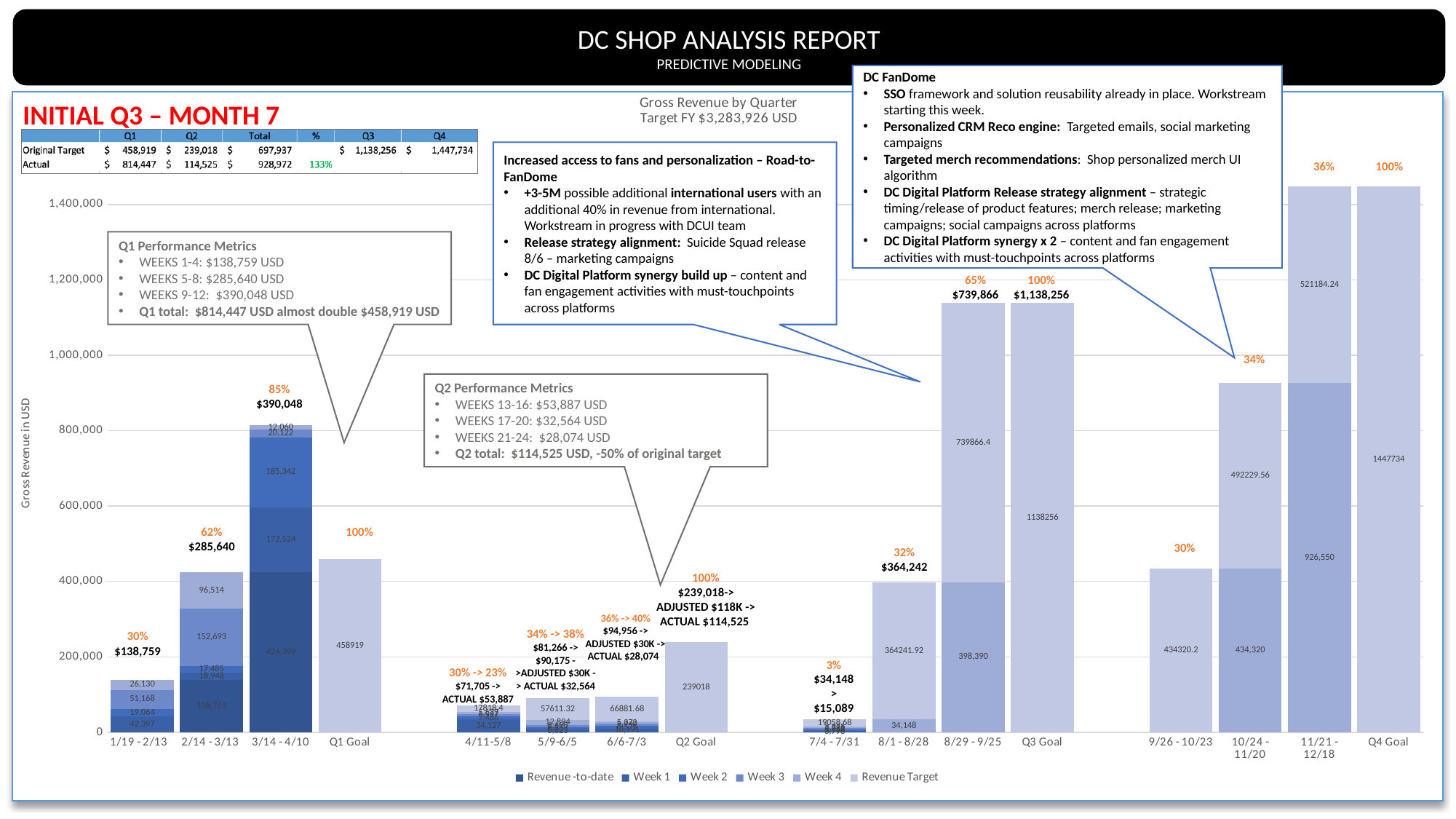
Which of the four quarterly goal bars (Q1 Goal, Q2 Goal, Q3 Goal, Q4 Goal) is the lowest? Q2 Goal How many categories are shown along the x axis of the chart? 16 What is the title of the vertical axis of the chart? Gross Revenue in USD What is the value labelled on the Q4 Goal bar? 1447734 What is the value labelled on the Q2 Goal bar? 239018 How many series does the chart legend list? 6 Is the total height of the 3/14 - 4/10 bar greater or less than 600,000? greater What is the difference between the Q4 Goal value and the Q3 Goal value? 309478 What kind of chart is shown on the slide? bar chart What is the value labelled on the Q1 Goal bar? 458919 What is the value labelled on the Q3 Goal bar? 1138256 Which of the four quarterly goal bars (Q1 Goal, Q2 Goal, Q3 Goal, Q4 Goal) is the highest? Q4 Goal